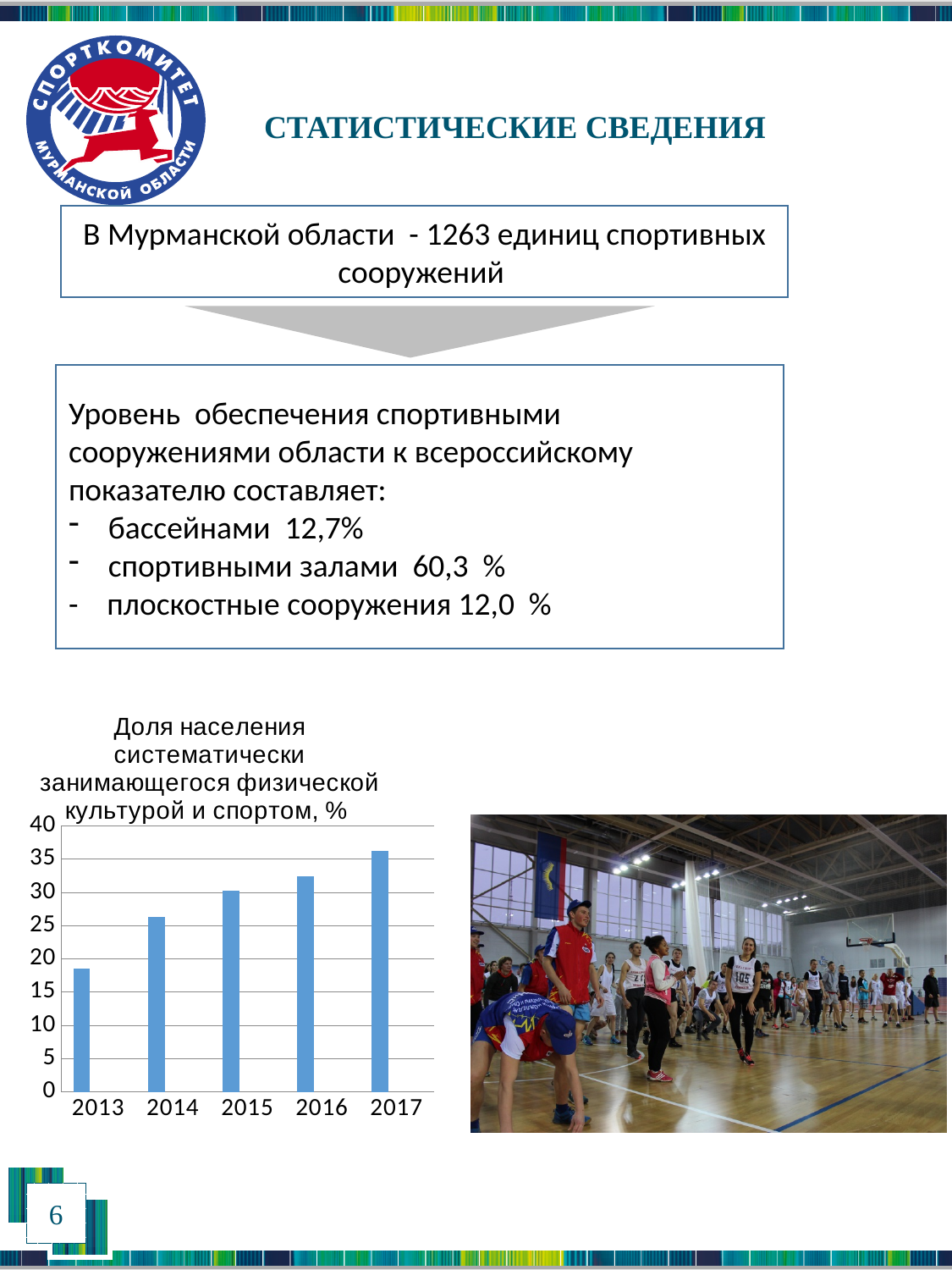
Which year has the lowest value in the chart? 2013 Is the value for 2013 greater or less than 20? less What is the title of the chart? Доля населения систематически занимающегося физической культурой и спортом, % Is the value for 2014 greater or less than 25? greater Do the values in the chart rise or fall from 2013 to 2017? rise Which year has the highest value in the chart? 2017 Which is larger, the value for 2016 or the value for 2014? 2016 What kind of chart is shown on the slide? bar chart Is the value for 2017 greater or less than 35? greater How many years are shown on the x axis of the chart? 5 What is the highest tick value shown on the y axis of the chart? 40